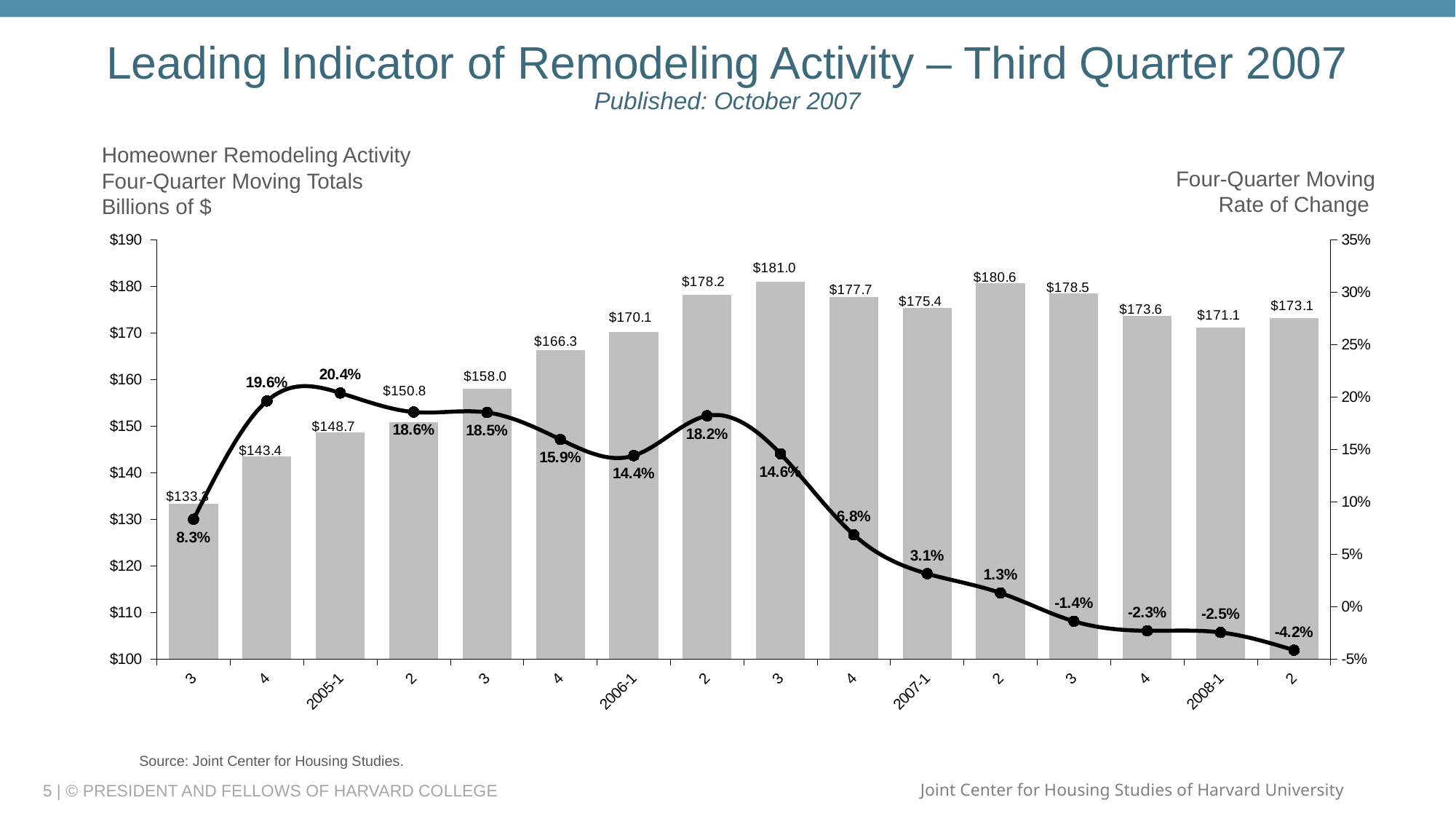
Which quarter has the highest four-quarter moving rate of change? 2005-1 (20.4%) Which quarter has the lowest four-quarter moving rate of change? 2008-2 (-4.2%) What is the title of the slide? Leading Indicator of Remodeling Activity – Third Quarter 2007 What kind of chart is shown on the slide? Combined bar and line chart What is the difference between the four-quarter moving totals for 2006-3 and 2006-4? $3.3 How many quarters are plotted on the chart? 16 Which quarter has the highest four-quarter moving total of remodeling activity? 2006-3 ($181.0) What is the four-quarter moving rate of change for 2005-1? 20.4% Which is larger, the four-quarter moving total for 2007-2 or for 2007-3? 2007-2 ($180.6) What is the four-quarter moving rate of change for 2007-1? 3.1% Does the four-quarter moving rate of change rise or fall from 2006-2 to 2008-2? Fall What is the four-quarter moving total of homeowner remodeling activity for 2006-1? $170.1